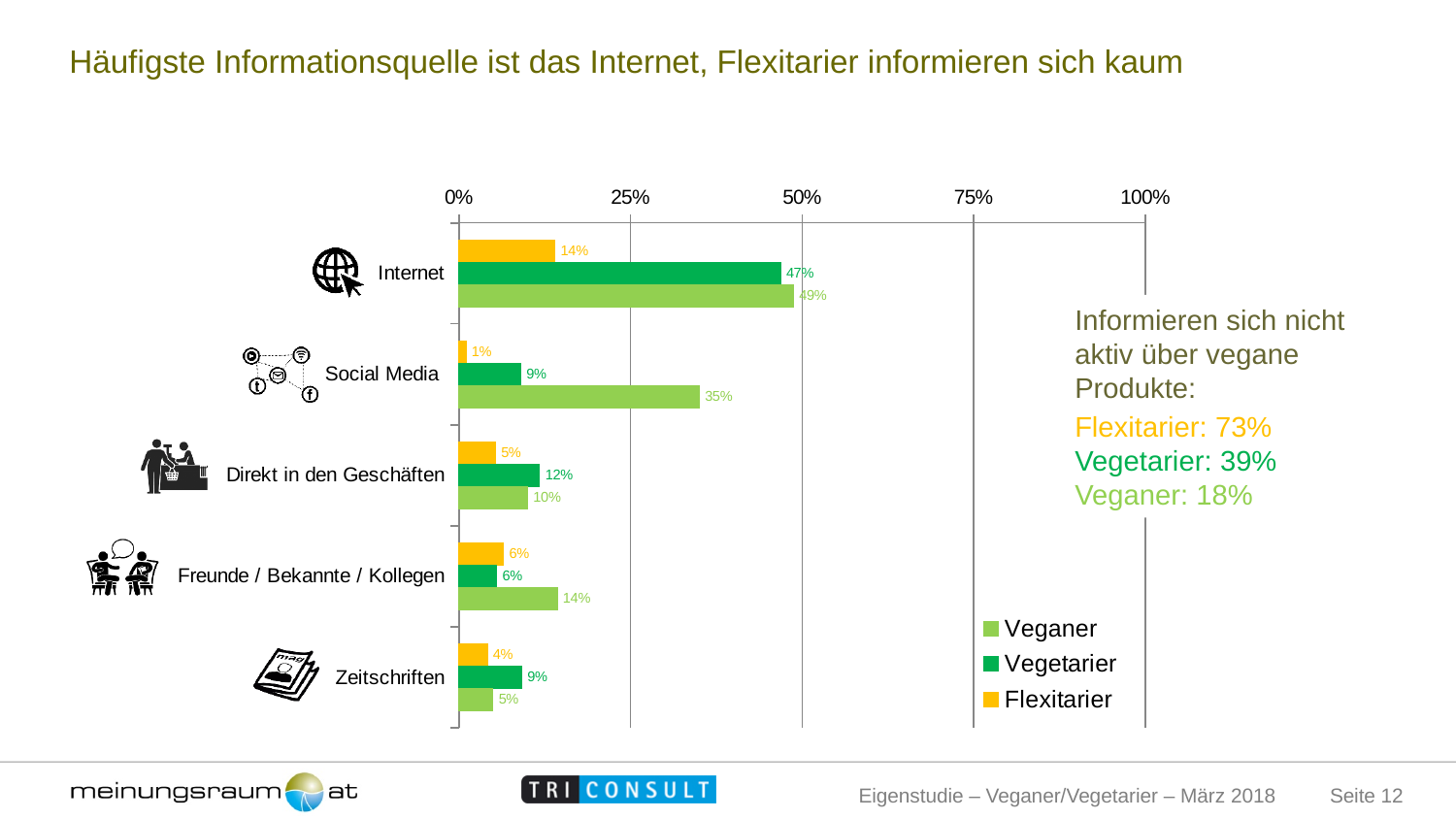
What is the value for Flexitarier in the Social Media category? 1% What is the value for Veganer in the Internet category? 49% Which category has the lowest value for Flexitarier? Social Media What kind of chart is shown on the slide? Bar chart Is the value for Veganer in the Internet category greater or less than 25%? greater What is the difference between the Veganer and Vegetarier values in the Social Media category? 26% How many categories are shown on the chart? 5 What is the value for Veganer in the Zeitschriften category? 5% In the Zeitschriften category, which is larger: the Vegetarier value or the Flexitarier value? Vegetarier Which category has the highest value for Veganer? Internet How many series does the legend list? 3 What is the value for Vegetarier in the Direkt in den Geschäften category? 12%